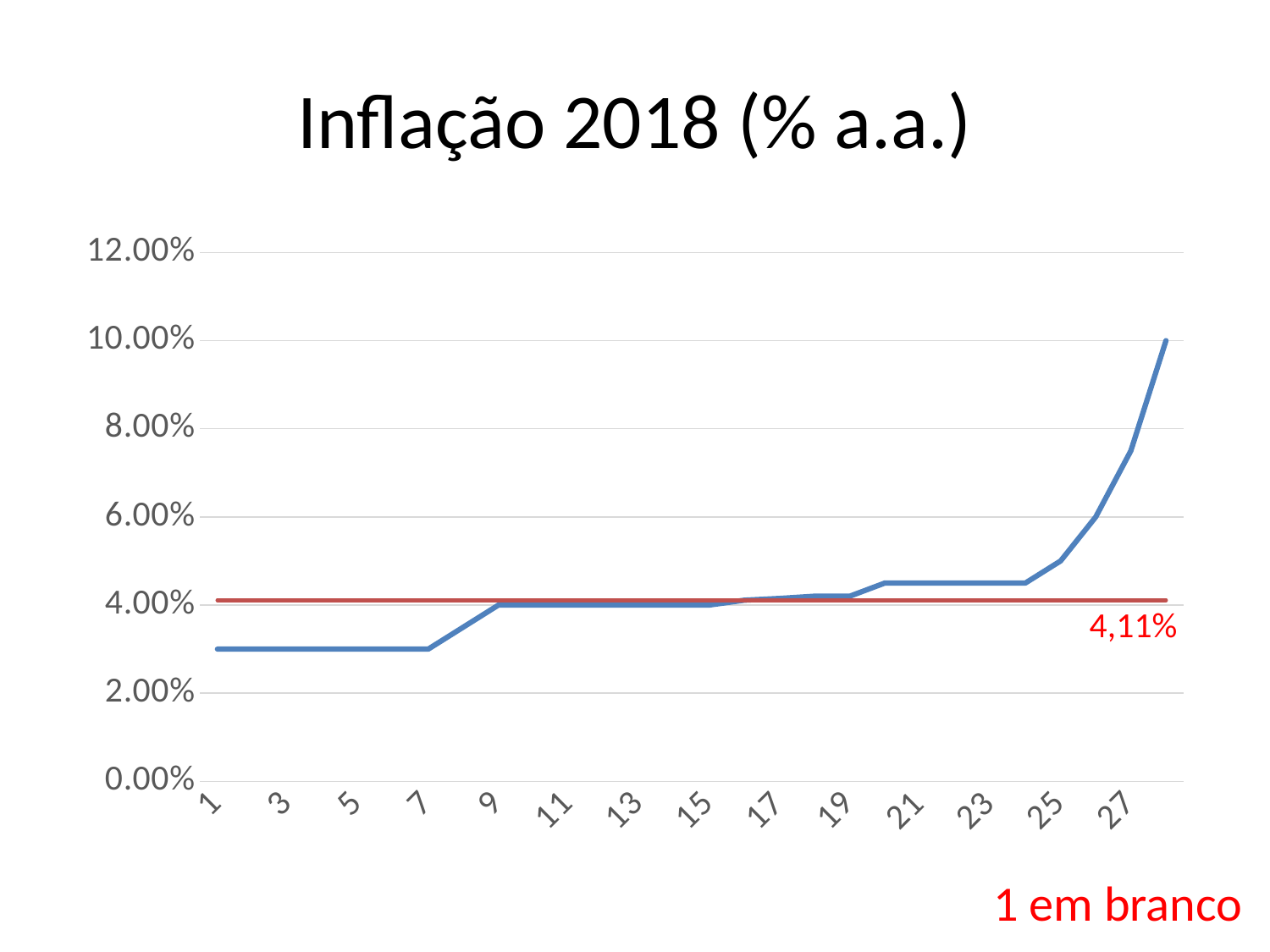
Does the blue line overall rise or fall from left to right? rise Is the value of the blue line at point 1 greater or less than 4.00%? less Is the value of the blue line at point 21 greater or less than 4.00%? greater Which is larger, the value of the blue line at point 27 or at point 1? point 27 What is the title of the chart? Inflação 2018 (% a.a.) What is the value of the blue line at point 11? 4.00% What colour is the horizontal reference line? red Is the highest value of the blue line greater or less than 12.00%? less What is the value of the blue line at its final point? 10.00% What value is labelled on the red horizontal line? 4,11% What kind of chart is shown on the slide? line chart